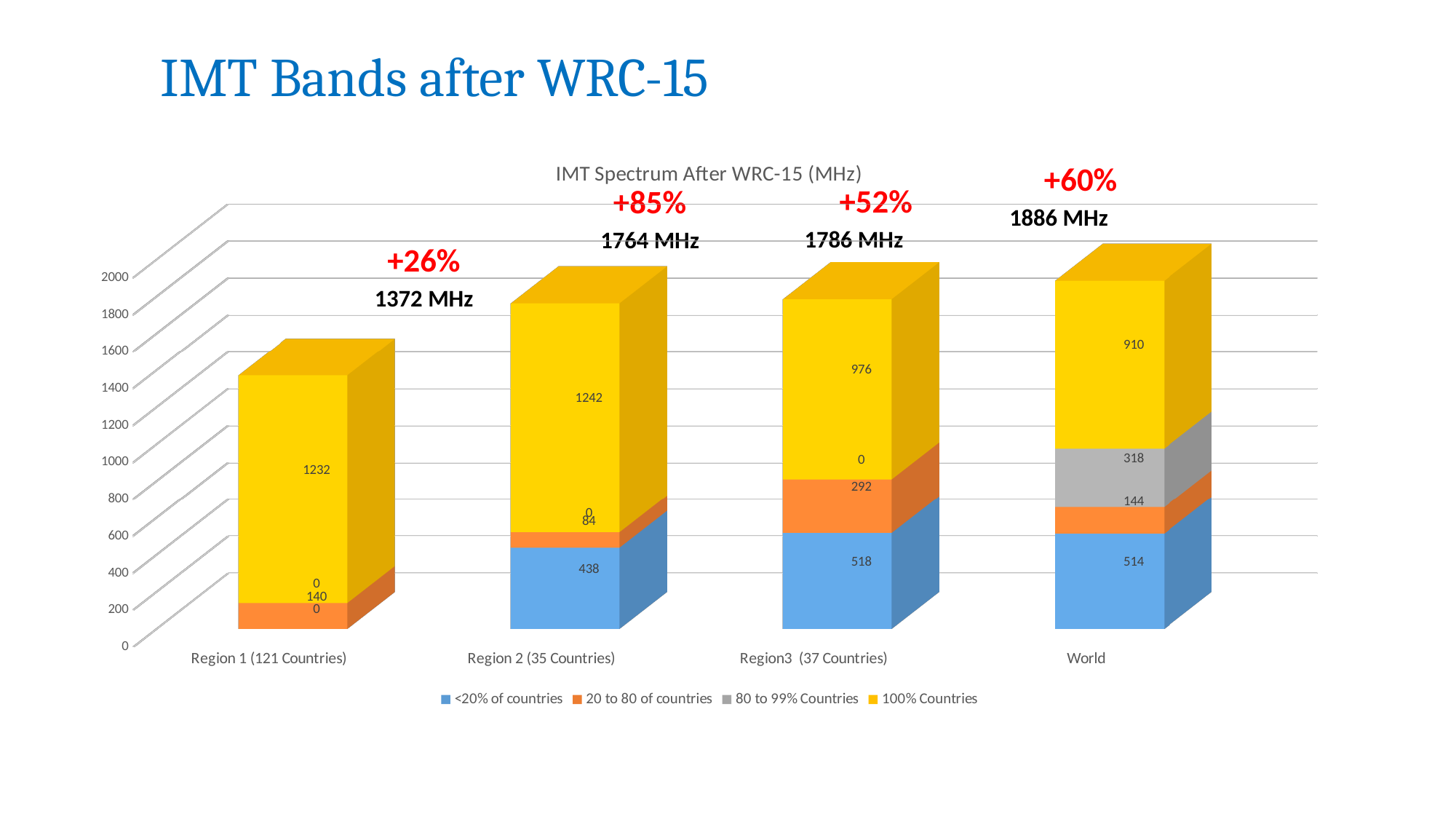
What is the total IMT spectrum shown for Region 2 (35 Countries)? 1764 MHz What is the value of the 100% Countries segment for Region 2 (35 Countries)? 1242 What is the value of the 80 to 99% Countries segment for World? 318 What type of chart is shown on the slide? Stacked bar chart Which category has the lowest total IMT spectrum? Region 1 (121 Countries) How many categories are shown on the x axis? 4 How many series does the legend list? 4 Which is larger, the 20 to 80 of countries value for Region3 (37 Countries) or for World? Region3 (37 Countries) What is the difference between the 100% Countries values for Region 1 (121 Countries) and World? 322 Which category has the highest total IMT spectrum? World What is the value of the <20% of countries segment for Region3 (37 Countries)? 518 What is the value of the 20 to 80 of countries segment for Region 1 (121 Countries)? 140